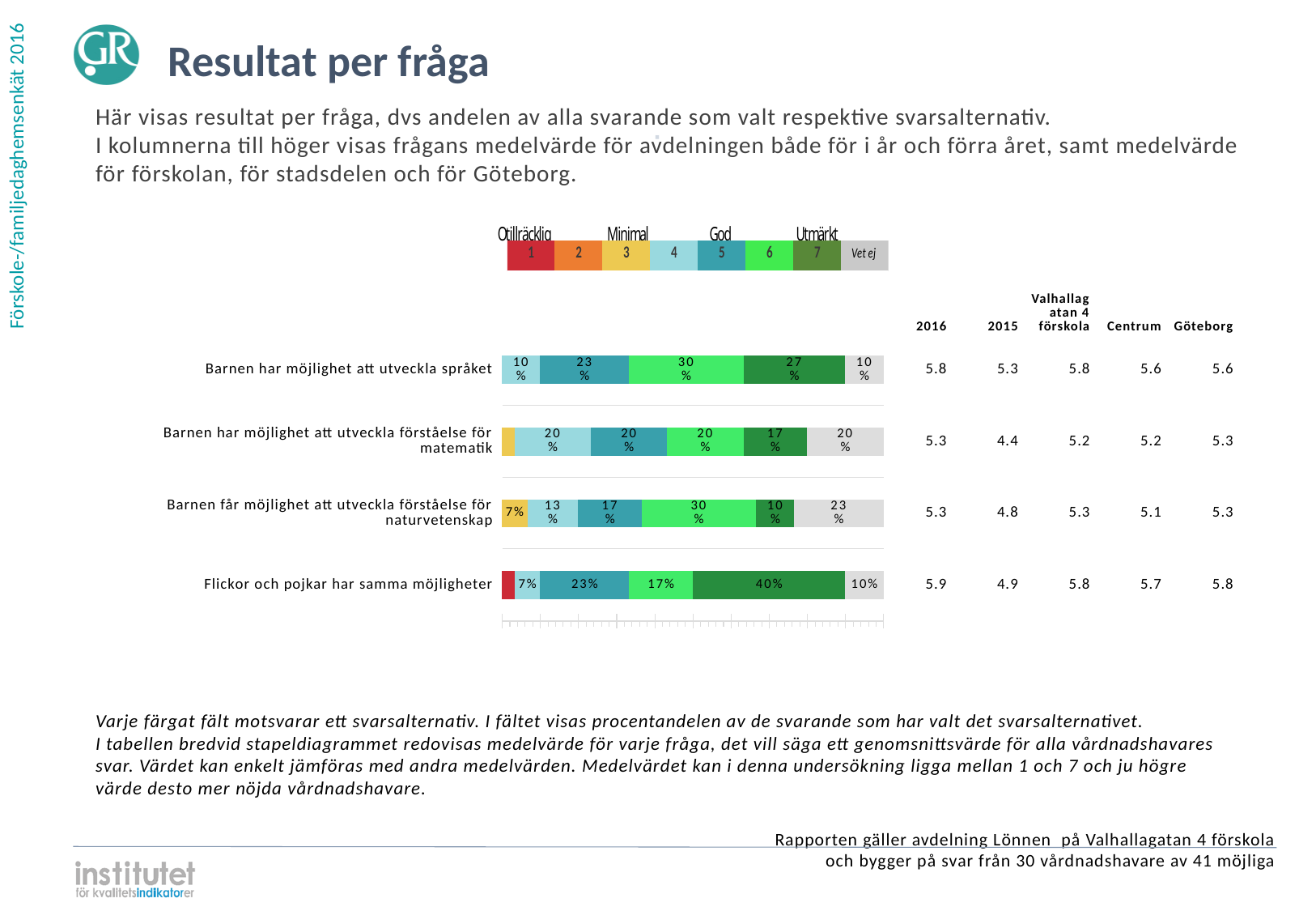
What kind of chart is used to show the results per question? bar chart What colour represents the answer alternative 'Vet ej' in the legend? grey What percentage chose the bright green alternative (6) for 'Barnen har möjlighet att utveckla språket'? 30% What percentage of respondents chose the dark green alternative (7, Utmärkt) for 'Flickor och pojkar har samma möjligheter'? 40% Which question has the largest share of 'Vet ej' answers? Barnen får möjlighet att utveckla förståelse för naturvetenskap How many questions (categories) are shown in the bar chart? 4 Which question has the largest share of respondents choosing the dark green alternative (7, Utmärkt)? Flickor och pojkar har samma möjligheter Which is larger: the teal (5) share for 'Barnen har möjlighet att utveckla språket' or for 'Barnen får möjlighet att utveckla förståelse för naturvetenskap'? Barnen har möjlighet att utveckla språket What percentage chose 'Vet ej' for 'Barnen får möjlighet att utveckla förståelse för naturvetenskap'? 23% How many answer alternatives does the legend above the chart list? 8 What is the difference between the dark green (7) share for 'Flickor och pojkar har samma möjligheter' and for 'Barnen har möjlighet att utveckla språket'? 13% What percentage chose the yellow alternative (3) for 'Barnen får möjlighet att utveckla förståelse för naturvetenskap'? 7%